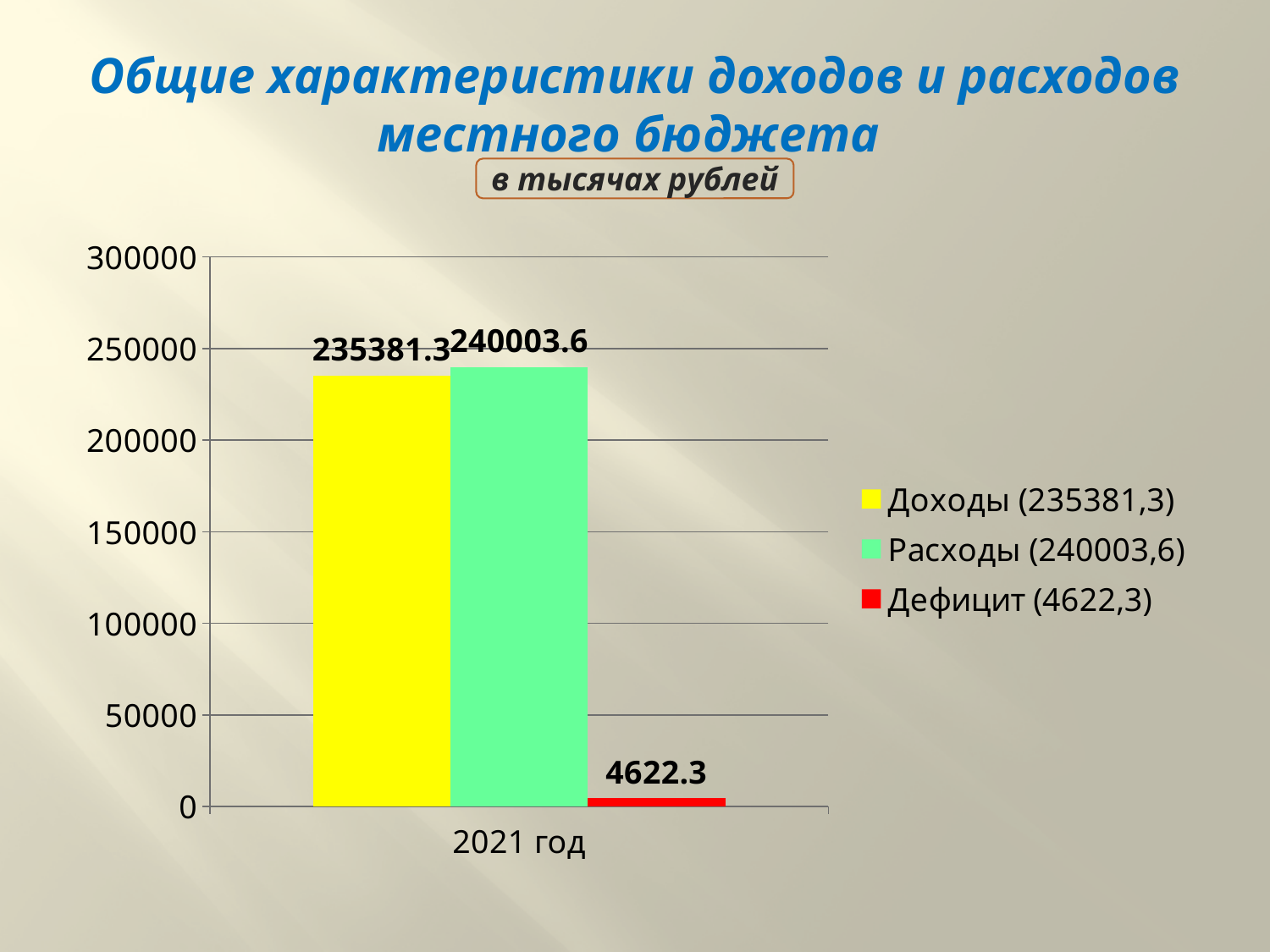
What is the difference between the Расходы value and the Доходы value? 4622.3 What is the value of the Доходы bar for 2021 год? 235381.3 Which is larger, the Доходы value or the Дефицит value? Доходы How many series does the legend list? 3 What is the value of the Расходы bar for 2021 год? 240003.6 What kind of chart is shown on the slide? bar chart Is the value for Дефицит greater or less than 50000? less What colour is the Дефицит series in the legend? red Which series has the highest value in the chart? Расходы Is the value for Доходы greater or less than 200000? greater Which series has the lowest value in the chart? Дефицит What is the value of the Дефицит bar for 2021 год? 4622.3